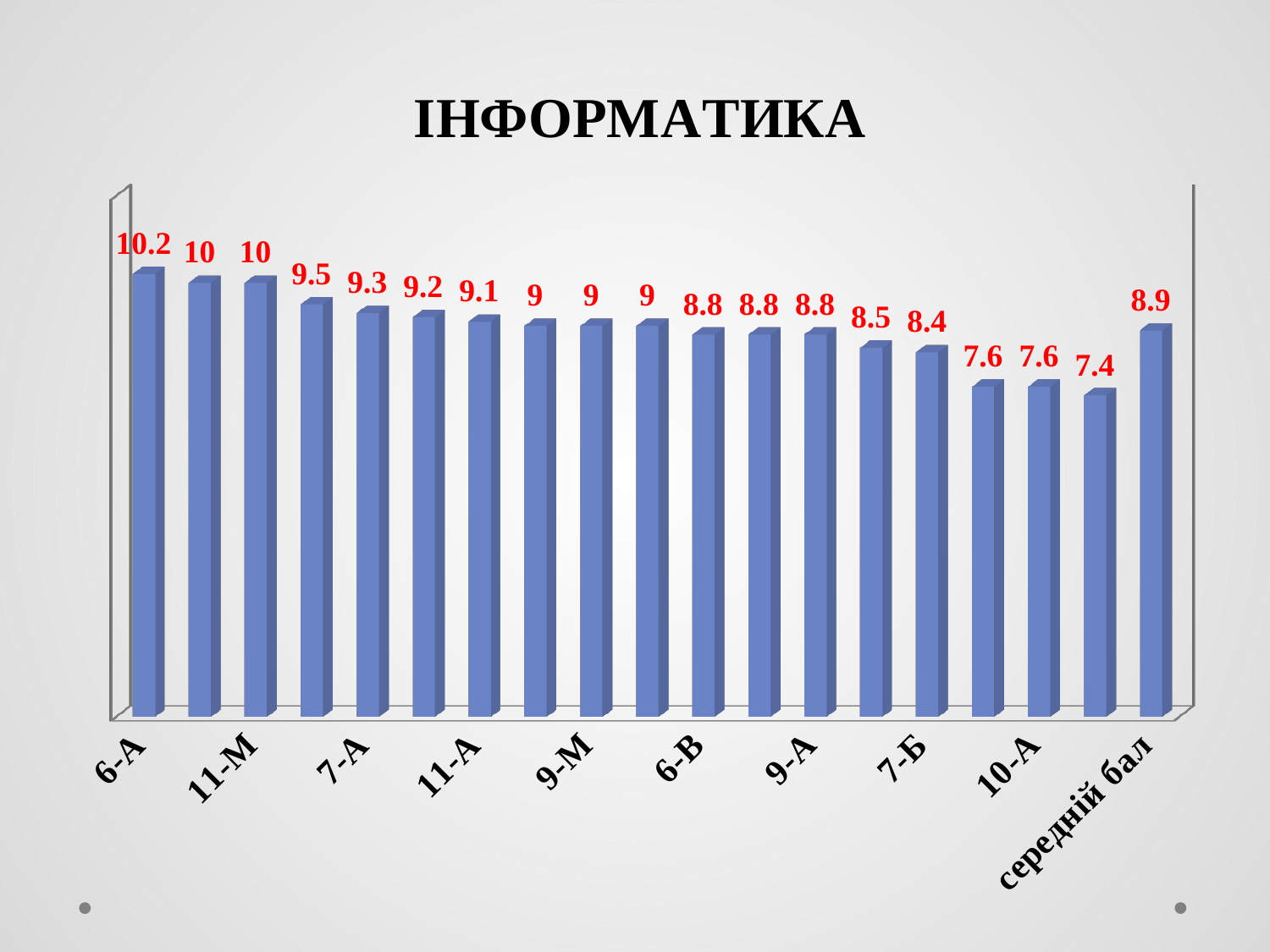
What is the title of the chart? ІНФОРМАТИКА What is the difference between the values for 6-А and 10-А? 2.6 Do the values generally rise or fall from left to right across the class bars (excluding the final середній бал bar)? fall What is the value for 7-Б? 8.4 Which category has the highest value? 6-А What is the lowest value shown on the chart? 7.4 How many bars are plotted on the chart? 19 Which is larger, the value for 6-А or the value for середній бал? 6-А What is the value for 10-А? 7.6 What is the value for 6-А? 10.2 What is the value for середній бал? 8.9 What kind of chart is shown on the slide? bar chart